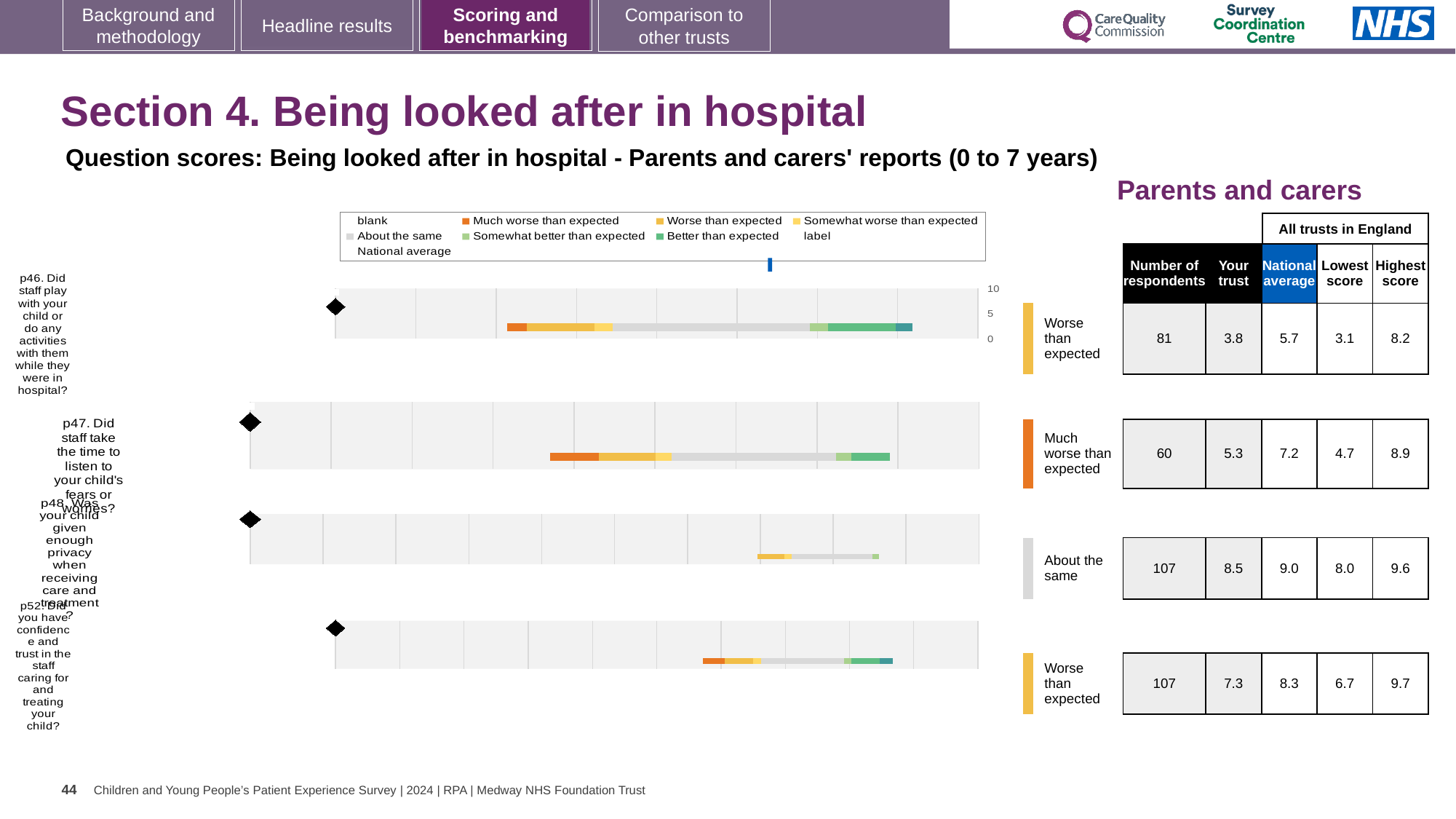
What is the highest score across all trusts in England for p52 (Did you have confidence and trust in the staff caring for and treating your child?)? 9.7 What kind of chart is used to show the question scores on this slide? bar chart What is the difference between the national average and the 'Your trust' score for p46? 1.9 How many respondents answered p48 (Was your child given enough privacy when receiving care and treatment?)? 107 How many survey questions (p46, p47, p48, p52) are plotted on the slide? 4 What benchmark category is shown for p47 (Did staff take the time to listen to your child's fears or worries?)? Much worse than expected Which question has the highest 'Your trust' score? p48 For p47, which is larger: the 'Your trust' score or the national average? National average Which question has the lowest 'Your trust' score? p46 What is the national average score for p47 (Did staff take the time to listen to your child's fears or worries?)? 7.2 What is the subtitle describing the question scores shown on the slide? Question scores: Being looked after in hospital - Parents and carers' reports (0 to 7 years) What is the 'Your trust' score for p46 (Did staff play with your child or do any activities with them while they were in hospital?)? 3.8